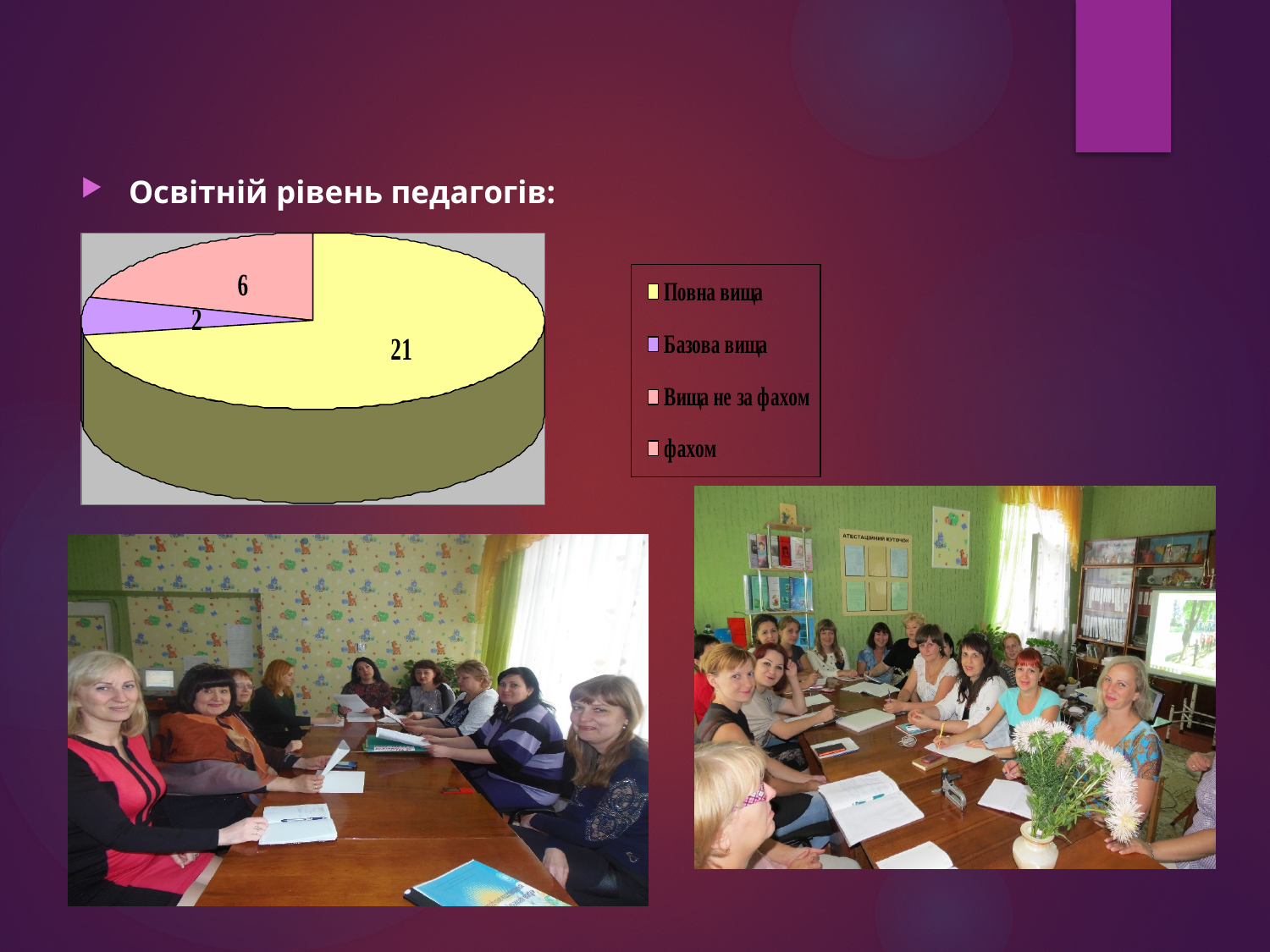
What is the difference between the values for "Повна вища" and "Вища не за фахом"? 15 What kind of chart is shown on the slide? Pie chart How many entries does the legend of the pie chart list? 4 What is the difference between the values for "Вища не за фахом" and "Базова вища"? 4 What value is shown for the "Базова вища" slice of the pie chart? 2 What value is shown for the "Повна вища" slice of the pie chart? 21 Which labelled category has the smallest slice in the pie chart? Базова вища Which category has the largest slice in the pie chart? Повна вища What colour is the "Повна вища" slice in the pie chart? Yellow How many data labels are printed on the pie chart? 3 What value is shown for the "Вища не за фахом" slice of the pie chart? 6 Which is larger, the value for "Вища не за фахом" or the value for "Базова вища"? Вища не за фахом